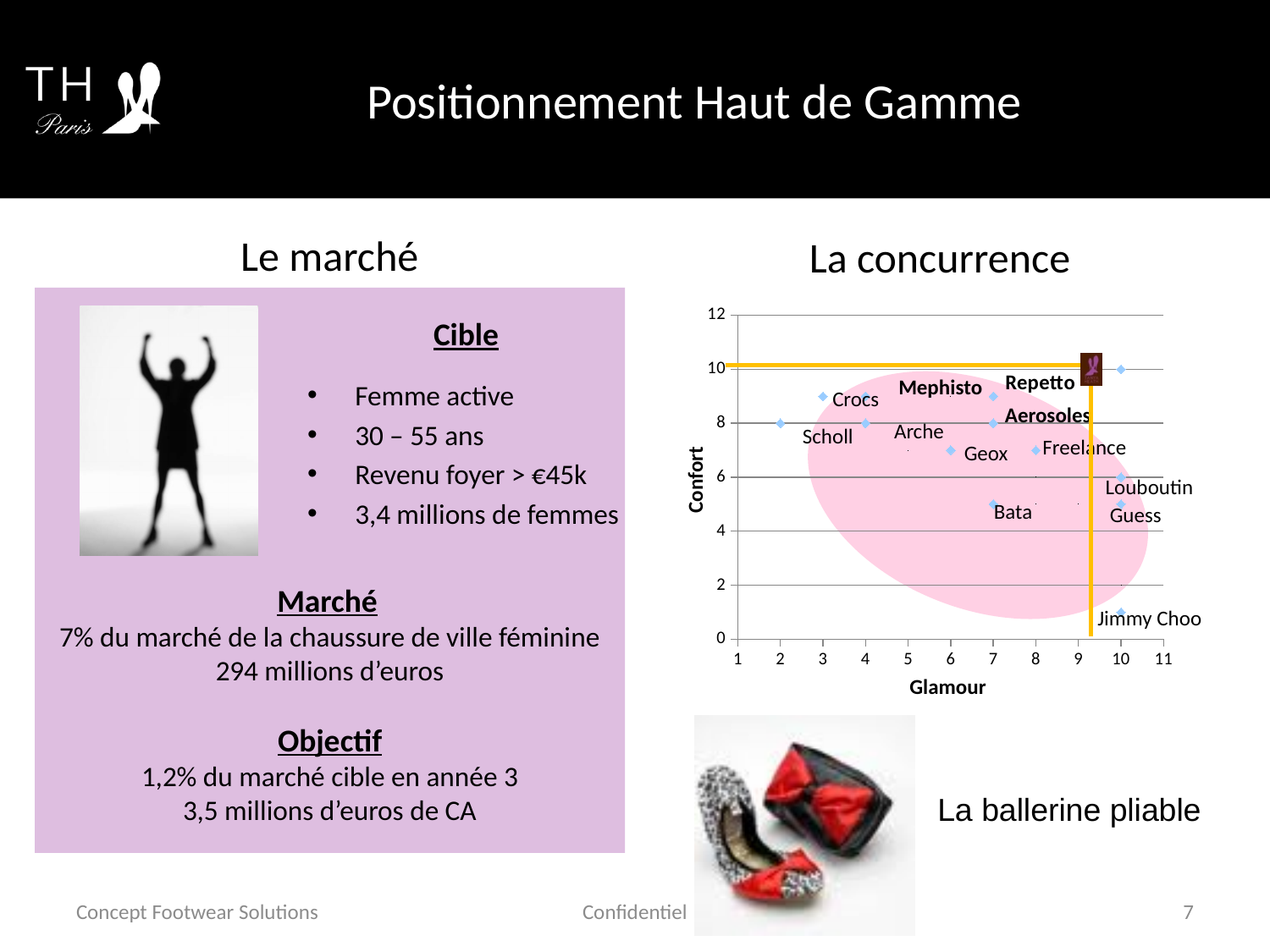
In the "La concurrence" chart, what is the Glamour value for Guess? 10 In the "La concurrence" chart, what is the Glamour value for Scholl? 2 In the "La concurrence" chart, what is the title of the horizontal axis? Glamour In the "La concurrence" chart, which has the higher Confort value, Crocs or Jimmy Choo? Crocs In the "La concurrence" chart, is the Confort value for Crocs greater or less than 8? greater What kind of chart is shown under "La concurrence"? scatter chart In the "La concurrence" chart, what is the Confort value for Scholl? 8 In the "La concurrence" chart, which labeled brand has the lowest Confort value? Jimmy Choo In the "La concurrence" chart, is the Confort value for Jimmy Choo greater or less than 2? less In the "La concurrence" chart, what is the title of the vertical axis? Confort In the "La concurrence" chart, which has the higher Glamour value, Scholl or Guess? Guess In the "La concurrence" chart, what is the Glamour value for Bata? 7